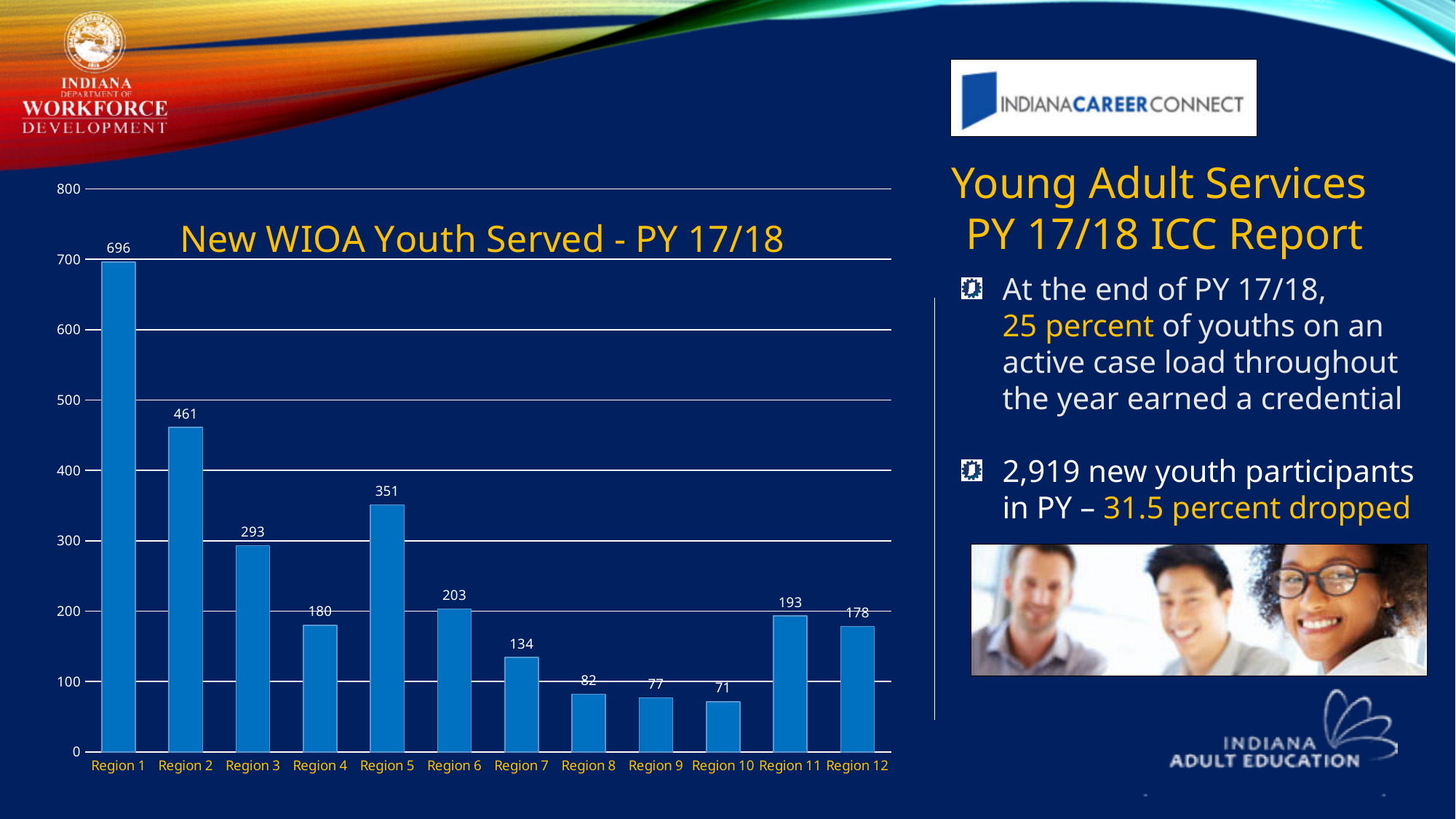
What is the value for Region 8? 82 What is the value for Region 5 in the New WIOA Youth Served - PY 17/18 chart? 351 Is the value for Region 7 greater or less than 100? greater What is the difference between the values for Region 1 and Region 2? 235 What is the title of the chart? New WIOA Youth Served - PY 17/18 How many new WIOA youth were served in Region 11? 193 Which region has the lowest number of new WIOA youth served? Region 10 How many regions are shown in the chart? 12 What kind of chart is shown on the slide? bar chart Which region has the highest number of new WIOA youth served? Region 1 Which is larger, the value for Region 3 or the value for Region 6? Region 3 What is the difference between the values for Region 11 and Region 12? 15